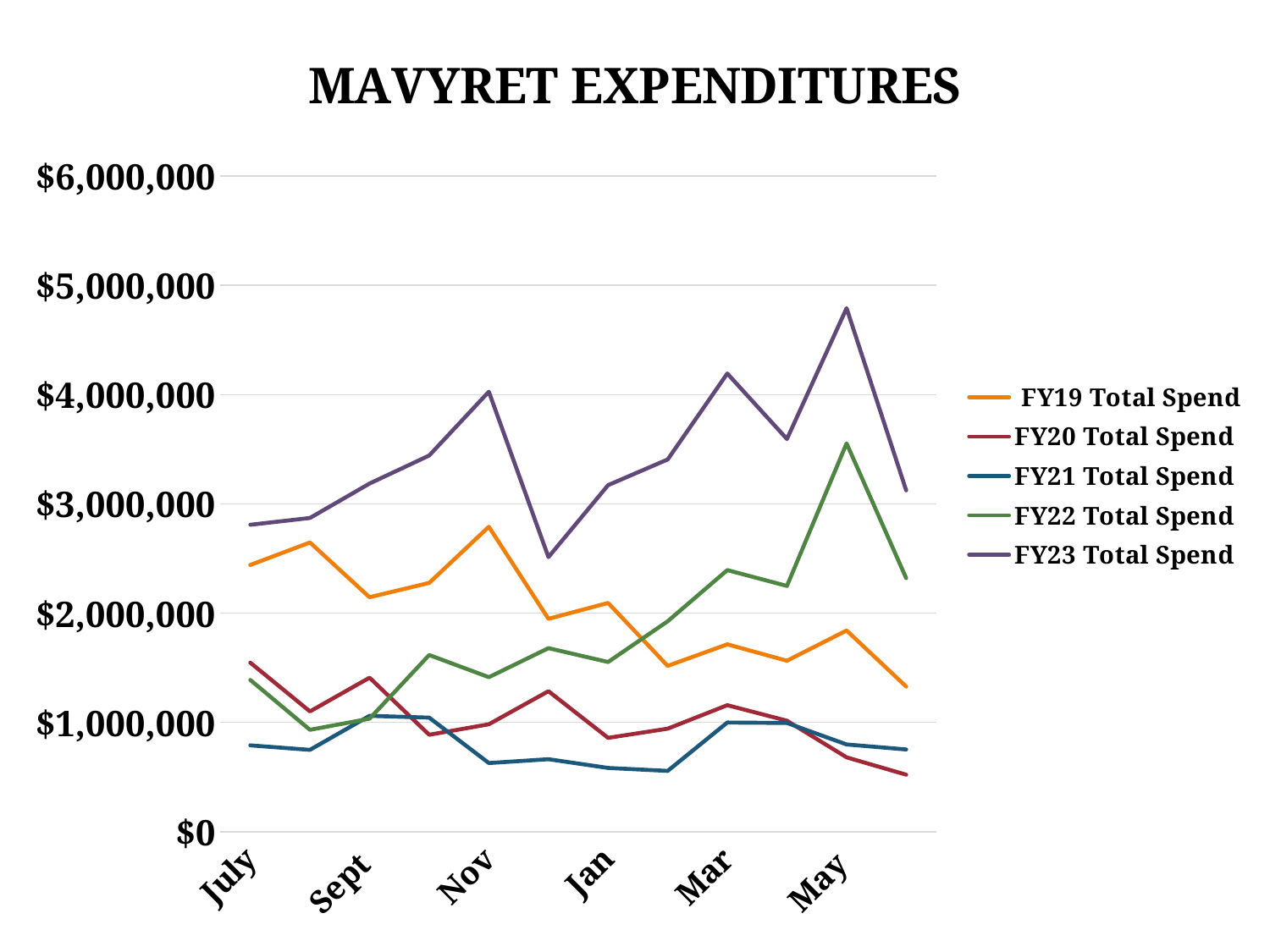
Which series has the highest value in May? FY23 Total Spend What kind of chart is shown on the slide? line chart What is the title of the chart? MAVYRET EXPENDITURES Is the value for FY23 Total Spend in May greater or less than $4,000,000? greater In which month does FY23 Total Spend reach its highest value? May How many series does the legend list? 5 In July, which is larger: FY19 Total Spend or FY21 Total Spend? FY19 Total Spend Which series has the lowest value in Nov? FY21 Total Spend Is the value for FY21 Total Spend in Nov greater or less than $1,000,000? less How many month labels are shown on the x axis? 6 Is the value for FY19 Total Spend in July greater or less than $2,000,000? greater